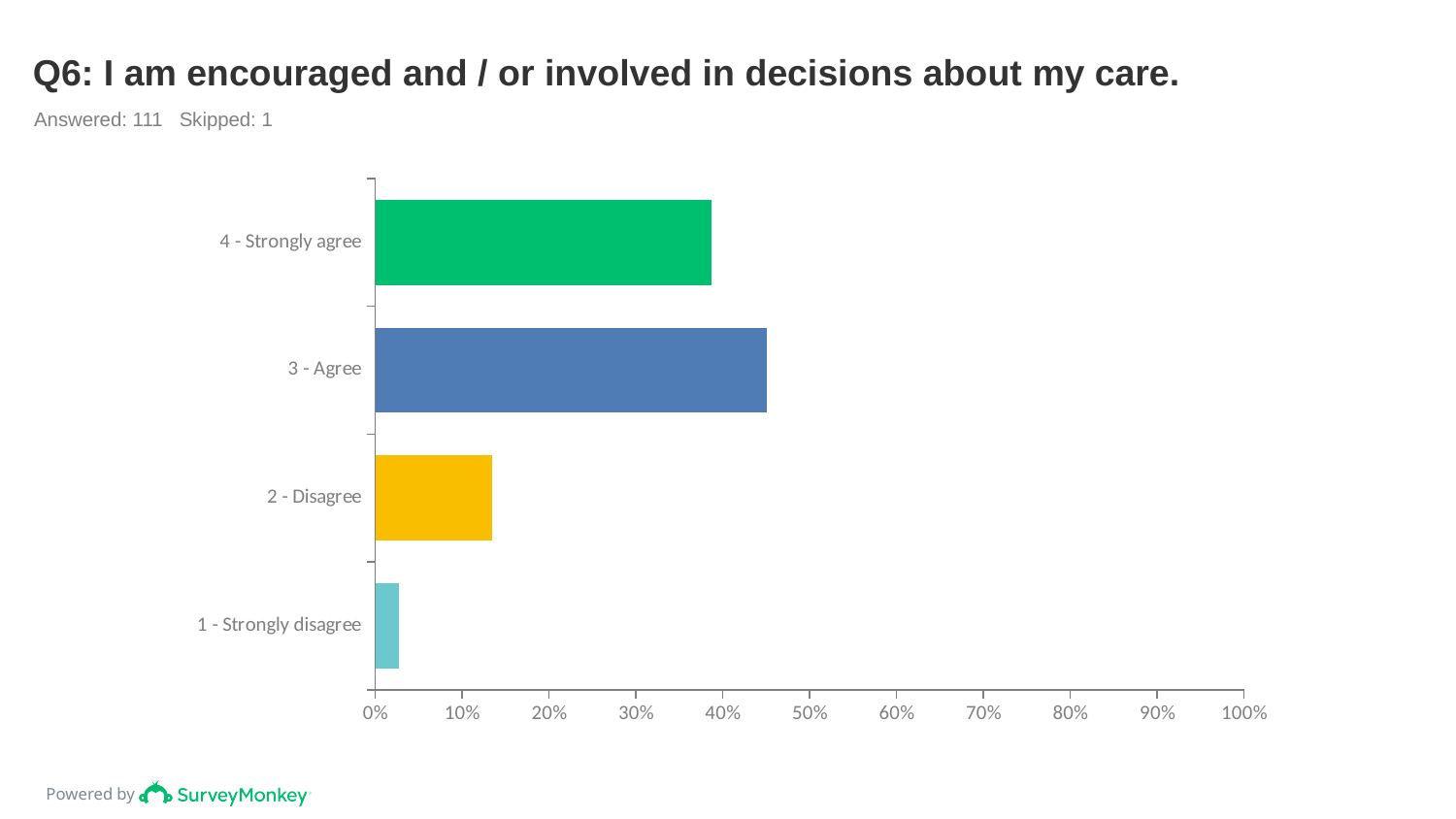
Which is larger, the value for 4 - Strongly agree or the value for 2 - Disagree? 4 - Strongly agree What is the title of the chart? Q6: I am encouraged and / or involved in decisions about my care. Is the value for 2 - Disagree greater or less than 20%? less How many response categories are plotted in the chart? 4 Which is larger, the value for 2 - Disagree or the value for 1 - Strongly disagree? 2 - Disagree Is the value for 1 - Strongly disagree greater or less than 10%? less How many respondents answered the question according to the slide? 111 Which response category has the highest value? 3 - Agree What kind of chart is shown on the slide? bar chart Which response category has the lowest value? 1 - Strongly disagree Is the value for 3 - Agree greater or less than 40%? greater